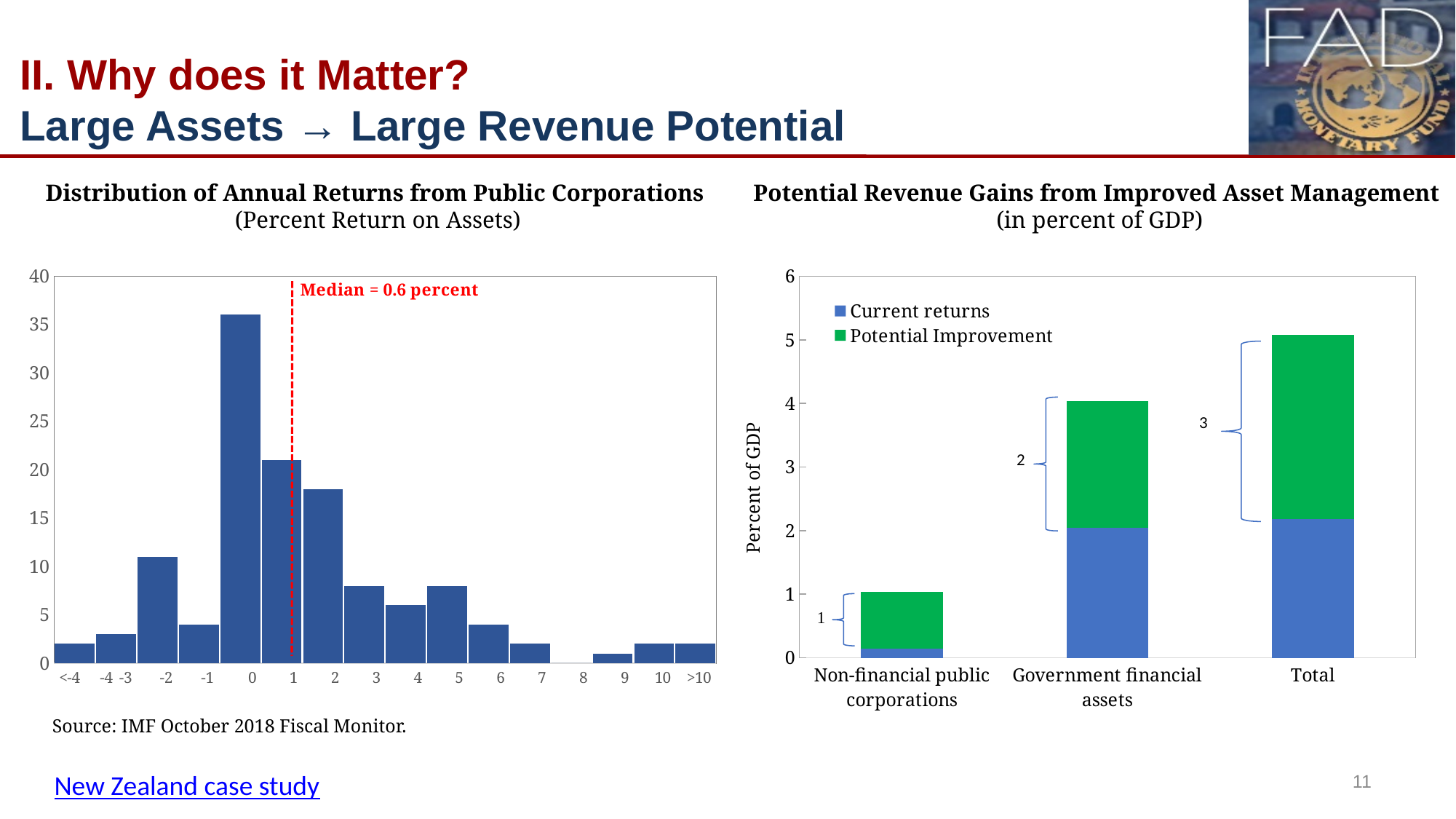
In the 'Potential Revenue Gains from Improved Asset Management' chart, which category has the shortest stacked bar? Non-financial public corporations How many return bins are shown on the x axis of the 'Distribution of Annual Returns from Public Corporations' chart? 16 In the 'Distribution of Annual Returns from Public Corporations' chart, which return bin has the highest bar? 0 In the 'Distribution of Annual Returns from Public Corporations' chart, which bar is taller, the one for 1 or the one for 3? 1 In the 'Distribution of Annual Returns from Public Corporations' chart, what median value is stated in the annotation? Median = 0.6 percent In the 'Potential Revenue Gains from Improved Asset Management' chart, which category has the tallest stacked bar? Total In the 'Distribution of Annual Returns from Public Corporations' chart, is the bar for the 0 bin greater or less than 30? greater In the 'Potential Revenue Gains from Improved Asset Management' chart, what is the y-axis label? Percent of GDP In the 'Potential Revenue Gains from Improved Asset Management' chart, is the total height of the 'Total' bar greater or less than 4? greater In the 'Distribution of Annual Returns from Public Corporations' chart, is the bar for the -2 bin greater or less than 15? less What kind of chart is the 'Distribution of Annual Returns from Public Corporations' chart? bar chart How many series does the legend list in the 'Potential Revenue Gains from Improved Asset Management' chart? 2